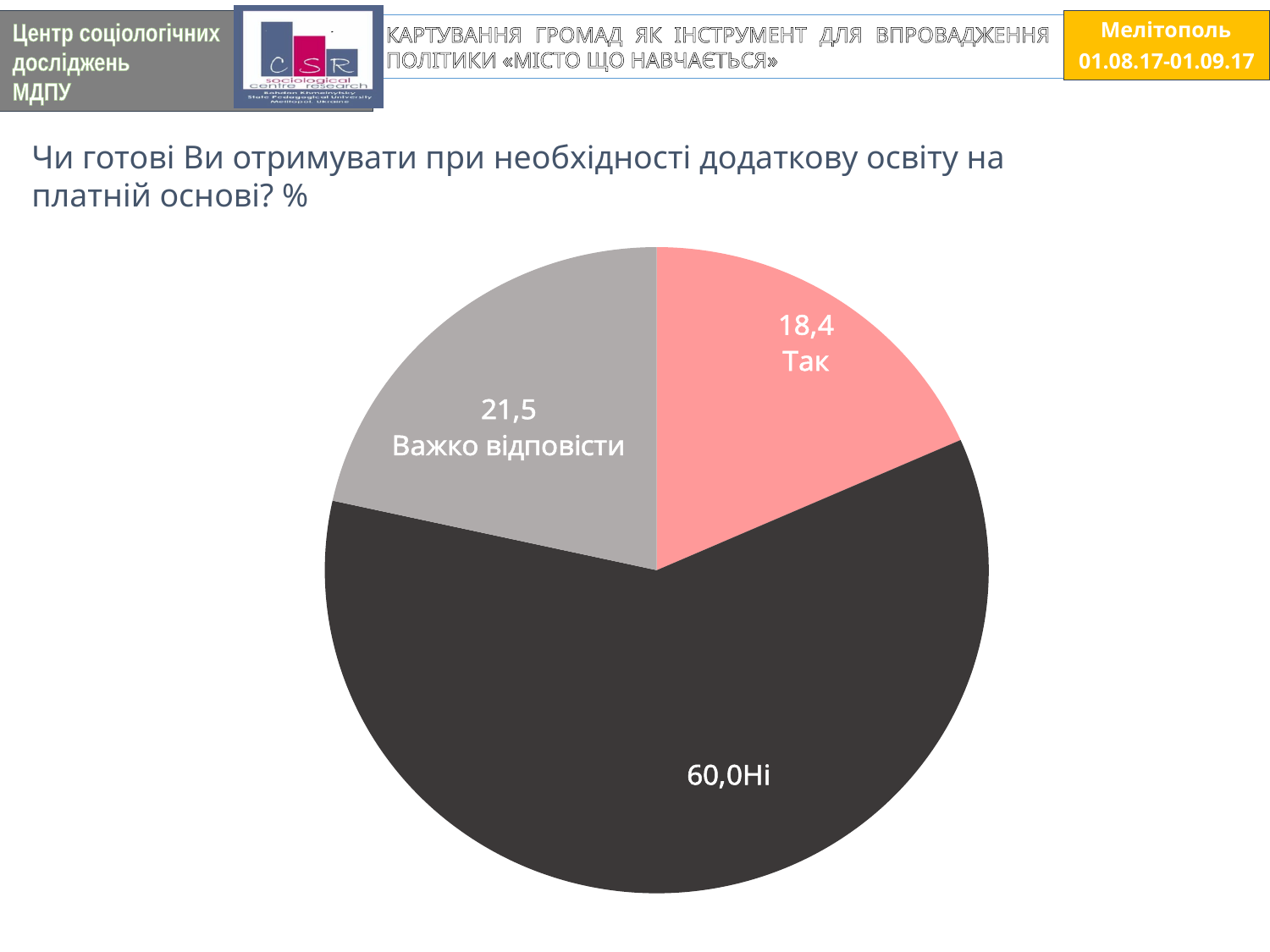
What is the difference between the values for "Важко відповісти" and "Так"? 3,1 What colour is the slice labelled "Так"? pink What is the value for the slice labelled "Ні"? 60,0 What share of the pie does the "Ні" slice represent? 60,0 Which is larger, the value for "Важко відповісти" or the value for "Так"? Важко відповісти What kind of chart is shown on the slide? pie chart Which slice of the pie is the largest? Ні What is the value for the slice labelled "Так"? 18,4 What is the difference between the values for "Ні" and "Так"? 41,6 Which slice of the pie is the smallest? Так What is the value for the slice labelled "Важко відповісти"? 21,5 How many slices does the pie chart have? 3